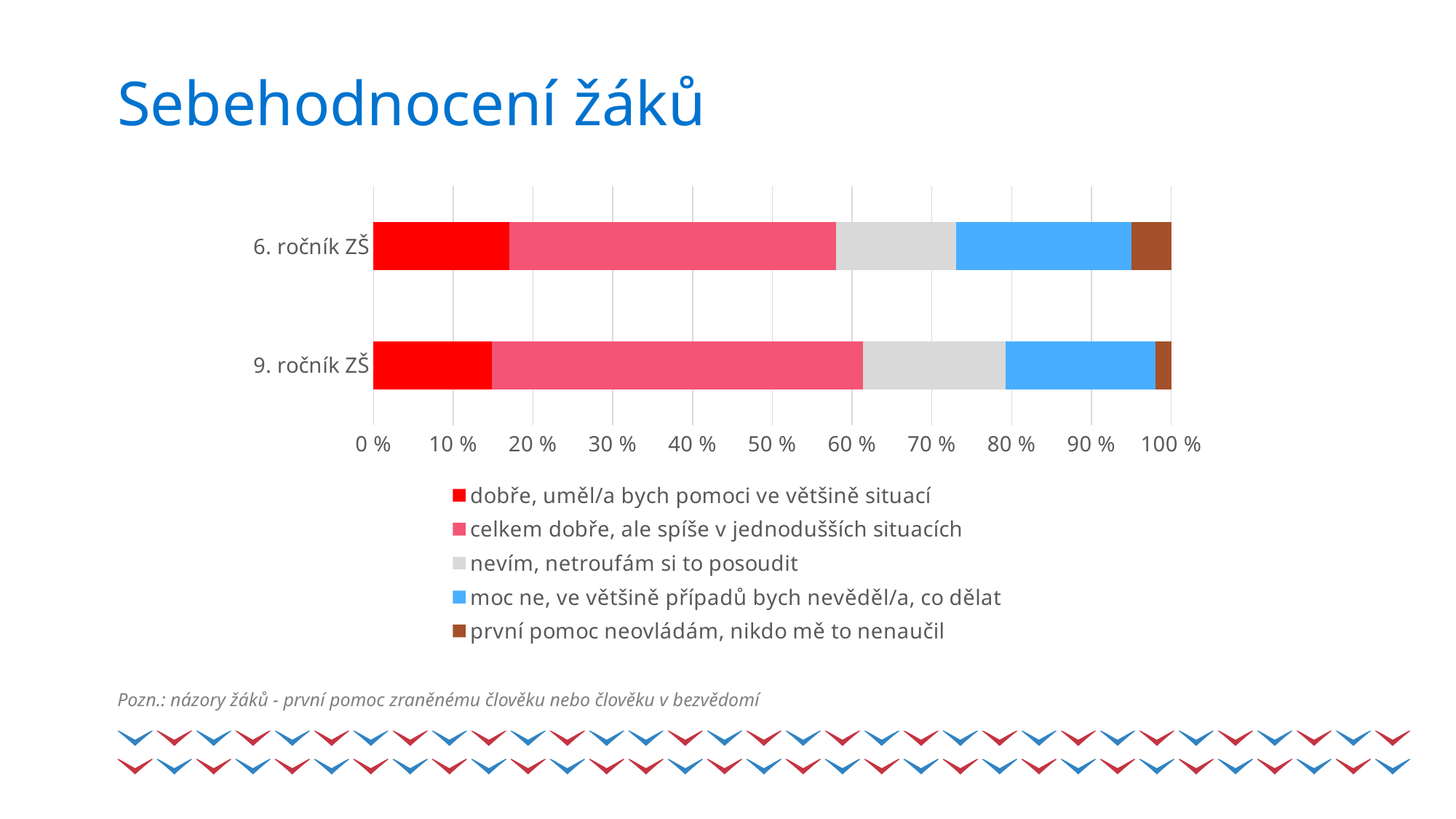
Which school year has the larger share for "první pomoc neovládám, nikdo mě to nenaučil"? 6. ročník ZŠ What does the stacked bar for 6. ročník ZŠ total on the x axis? 100 % Is the value for "moc ne, ve většině případů bych nevěděl/a, co dělat" for 6. ročník ZŠ greater or less than 10 %? greater Which school year has the larger share for "celkem dobře, ale spíše v jednodušších situacích"? 9. ročník ZŠ What is the title of the slide containing the chart? Sebehodnocení žáků What kind of chart is shown on the slide? stacked bar chart Is the value for "dobře, uměl/a bych pomoci ve většině situací" for 6. ročník ZŠ greater or less than 20 %? less Which legend entry is shown in red? dobře, uměl/a bych pomoci ve většině situací Is the value for "celkem dobře, ale spíše v jednodušších situacích" for 9. ročník ZŠ greater or less than 40 %? greater How many series does the legend list? 5 How many categories (school years) are plotted on the chart? 2